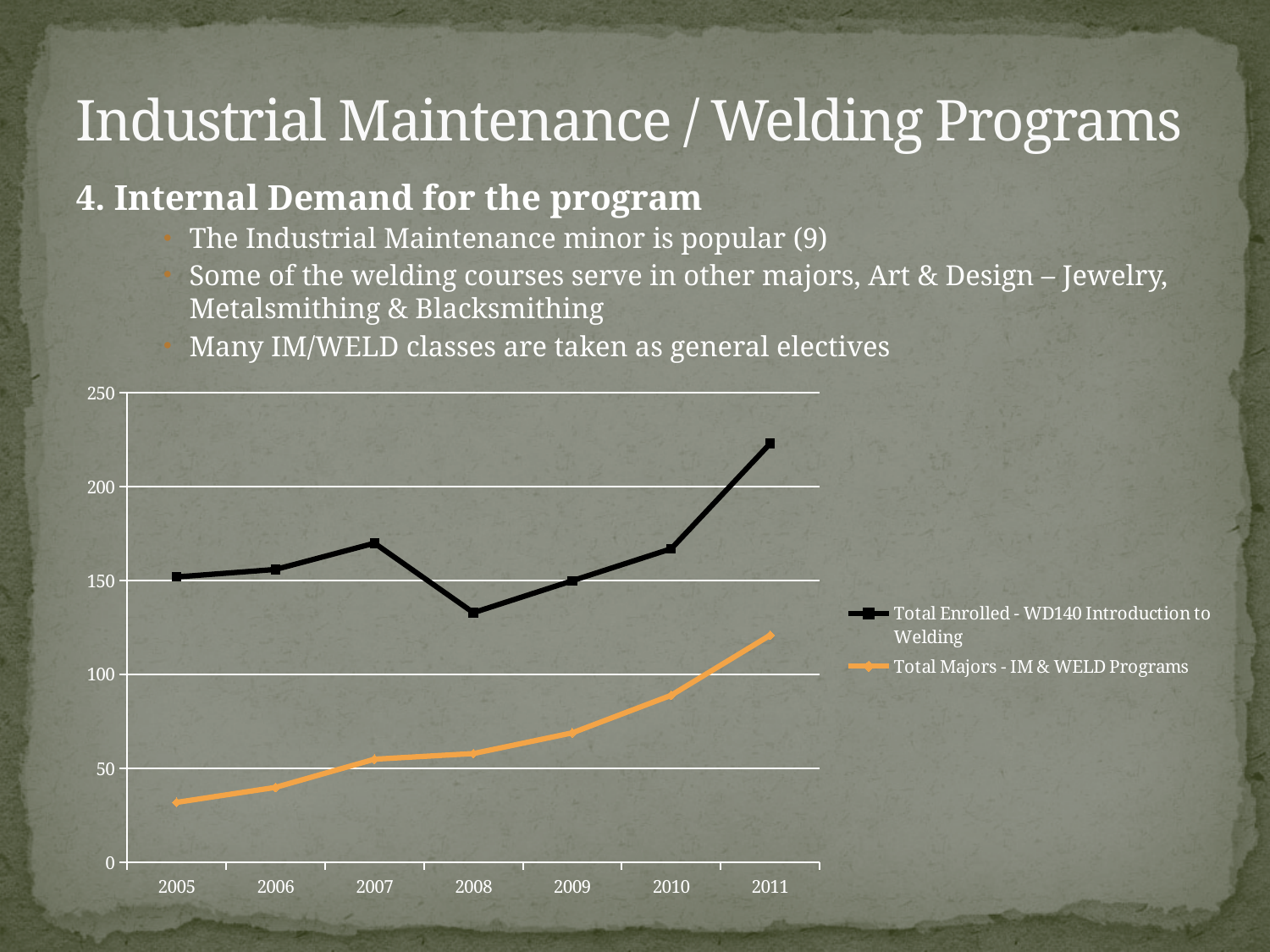
Is the value for Total Majors - IM & WELD Programs in 2005 greater or less than 50? less Does the Total Majors - IM & WELD Programs series rise or fall from 2005 to 2011? rise Which series has the higher value in 2008, Total Enrolled - WD140 Introduction to Welding or Total Majors - IM & WELD Programs? Total Enrolled - WD140 Introduction to Welding What kind of chart is shown on the slide? line chart How many series does the chart's legend list? 2 In which year is the Total Enrolled - WD140 Introduction to Welding series at its lowest? 2008 In which year is the Total Majors - IM & WELD Programs series at its lowest? 2005 How many years are plotted along the x axis of the chart? 7 Is the value for Total Enrolled - WD140 Introduction to Welding in 2011 greater or less than 200? greater Is the value for Total Majors - IM & WELD Programs in 2011 greater or less than 100? greater In which year is the Total Enrolled - WD140 Introduction to Welding series at its highest? 2011 What colour is the line for Total Majors - IM & WELD Programs? orange